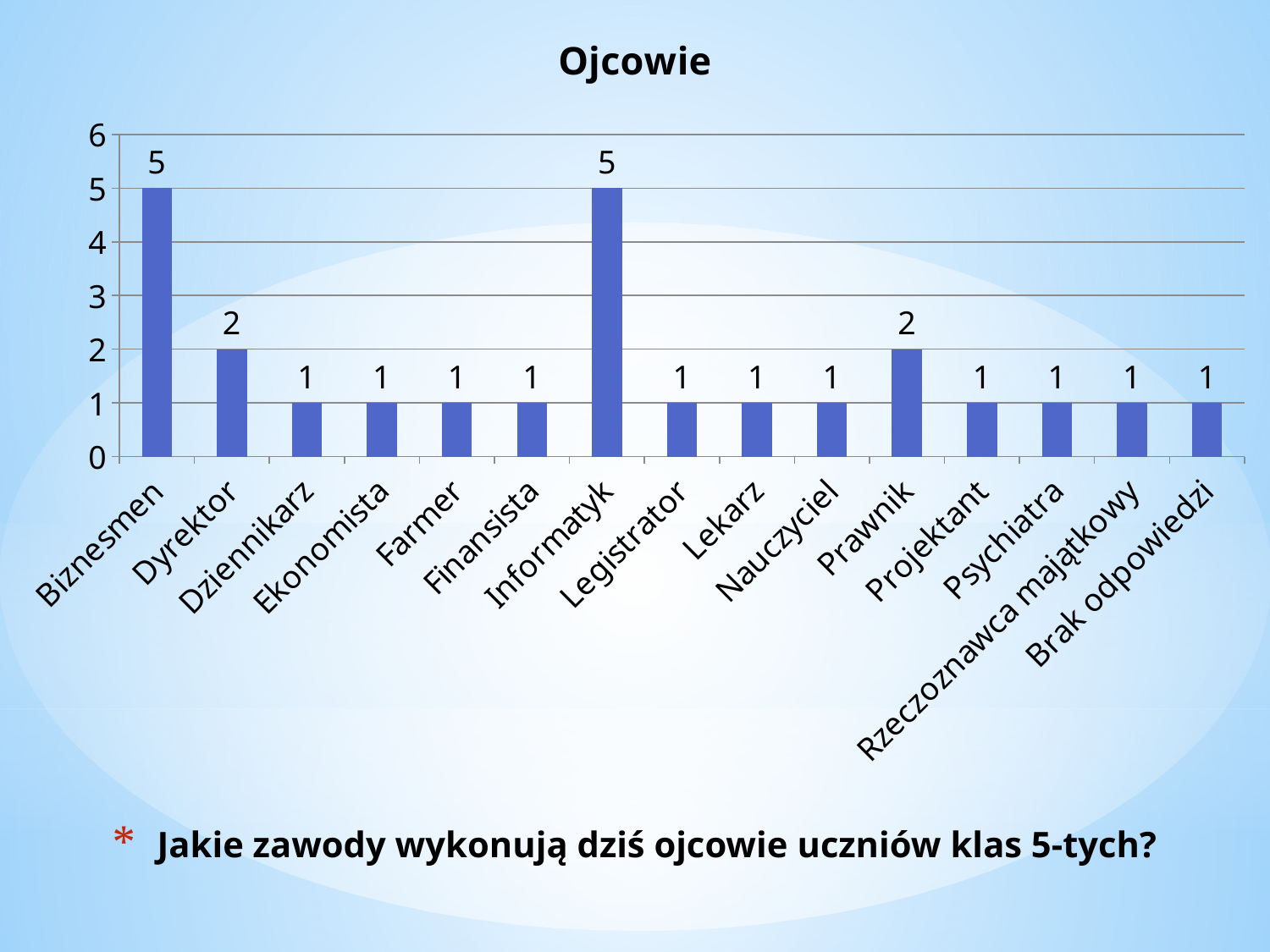
What kind of chart is shown on the slide? bar chart What is the value for Prawnik? 2 What is the value for Biznesmen? 5 What is the value for Informatyk? 5 Which is larger, the value for Dyrektor or the value for Farmer? Dyrektor How many categories are shown on the x axis? 15 What is the difference between the values for Biznesmen and Dyrektor? 3 What is the difference between the values for Informatyk and Lekarz? 4 Which is larger, the value for Informatyk or the value for Prawnik? Informatyk What is the value for Brak odpowiedzi? 1 What is the title of the chart? Ojcowie What is the highest value shown on the chart? 5